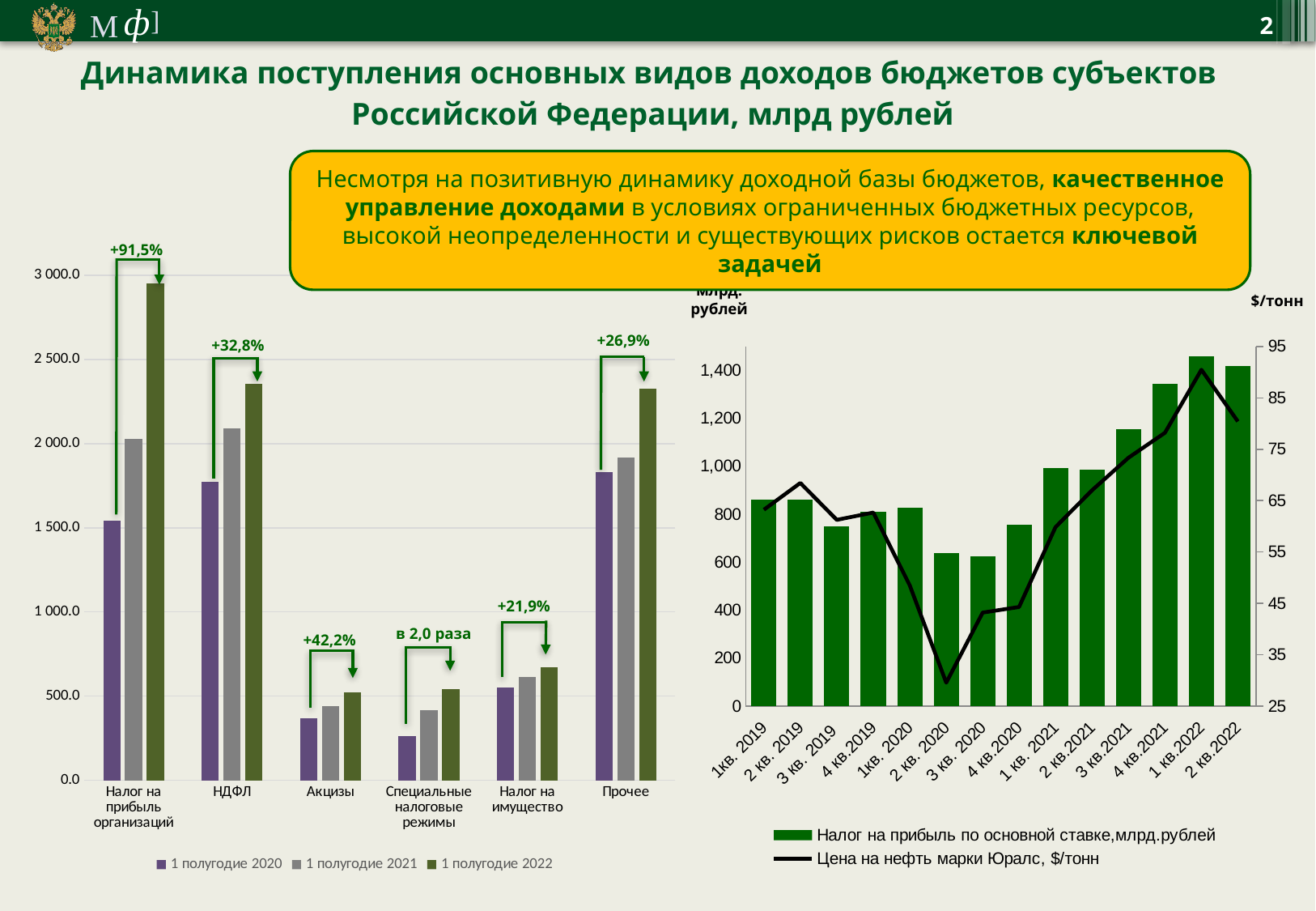
In the left chart, is the value for Специальные налоговые режимы in 1 полугодие 2020 greater or less than 500.0? less What kind of chart is the left chart on the slide? bar chart In the left chart, is the value for Налог на прибыль организаций in 1 полугодие 2022 greater or less than 2 500.0? greater In the right chart, in which quarter does the line Цена на нефть марки Юралс reach its lowest point? 2 кв. 2020 How many categories are shown on the x axis of the left chart? 6 In the left chart, what growth label is printed above the bars for Специальные налоговые режимы? в 2,0 раза How many series does the legend of the right chart list? 2 In the left chart, which is larger for 1 полугодие 2021: НДФЛ or Прочее? НДФЛ In the left chart, what growth percentage is printed above the bars for Налог на прибыль организаций? +91,5% How many series does the legend of the left chart list? 3 In the right chart, how many quarters are shown on the x axis? 14 In the left chart, which category has the highest bar for 1 полугодие 2022? Налог на прибыль организаций